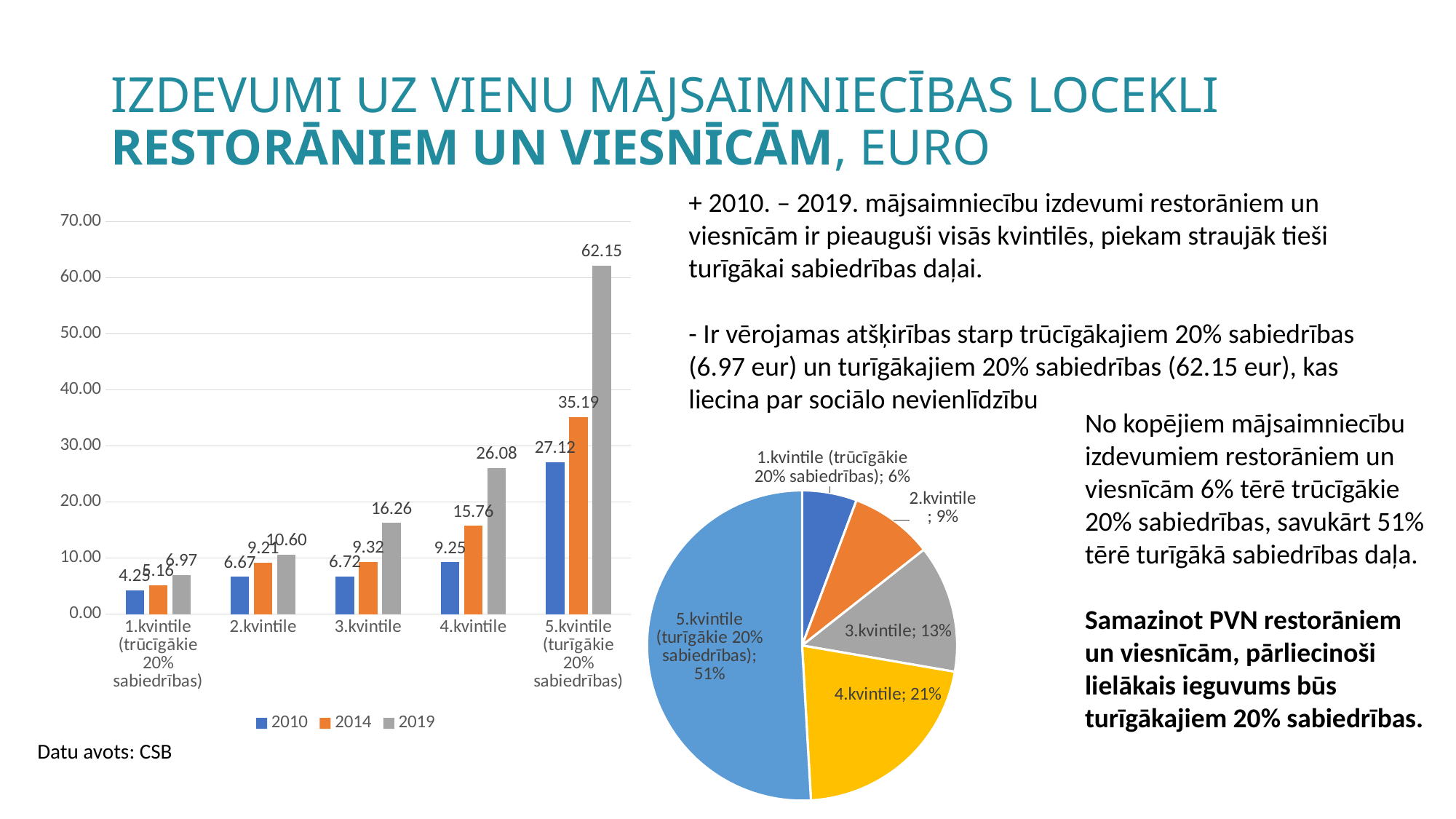
In the bar chart on the left, which is larger: the 2014 value for 4.kvintile or the 2019 value for 3.kvintile? 2019 value for 3.kvintile In the bar chart on the left, which category has the lowest value in 2010? 1.kvintile In the bar chart on the left, what is the value for 3.kvintile in 2014? 9.32 In the bar chart on the left, what is the value for 1.kvintile in 2010? 4.25 In the bar chart on the left, do the 2019 values rise or fall from 1.kvintile to 5.kvintile? rise In the pie chart on the right, what share does 4.kvintile have? 21% In the bar chart on the left, what is the value for 5.kvintile in 2019? 62.15 What kind of chart is the chart on the right of the slide? pie chart In the bar chart on the left, how many series does the legend list? 3 In the pie chart on the right, how many slices are there? 5 In the bar chart on the left, what is the difference between the 2019 and 2010 values for 5.kvintile? 35.03 In the bar chart on the left, which category has the highest value in 2019? 5.kvintile